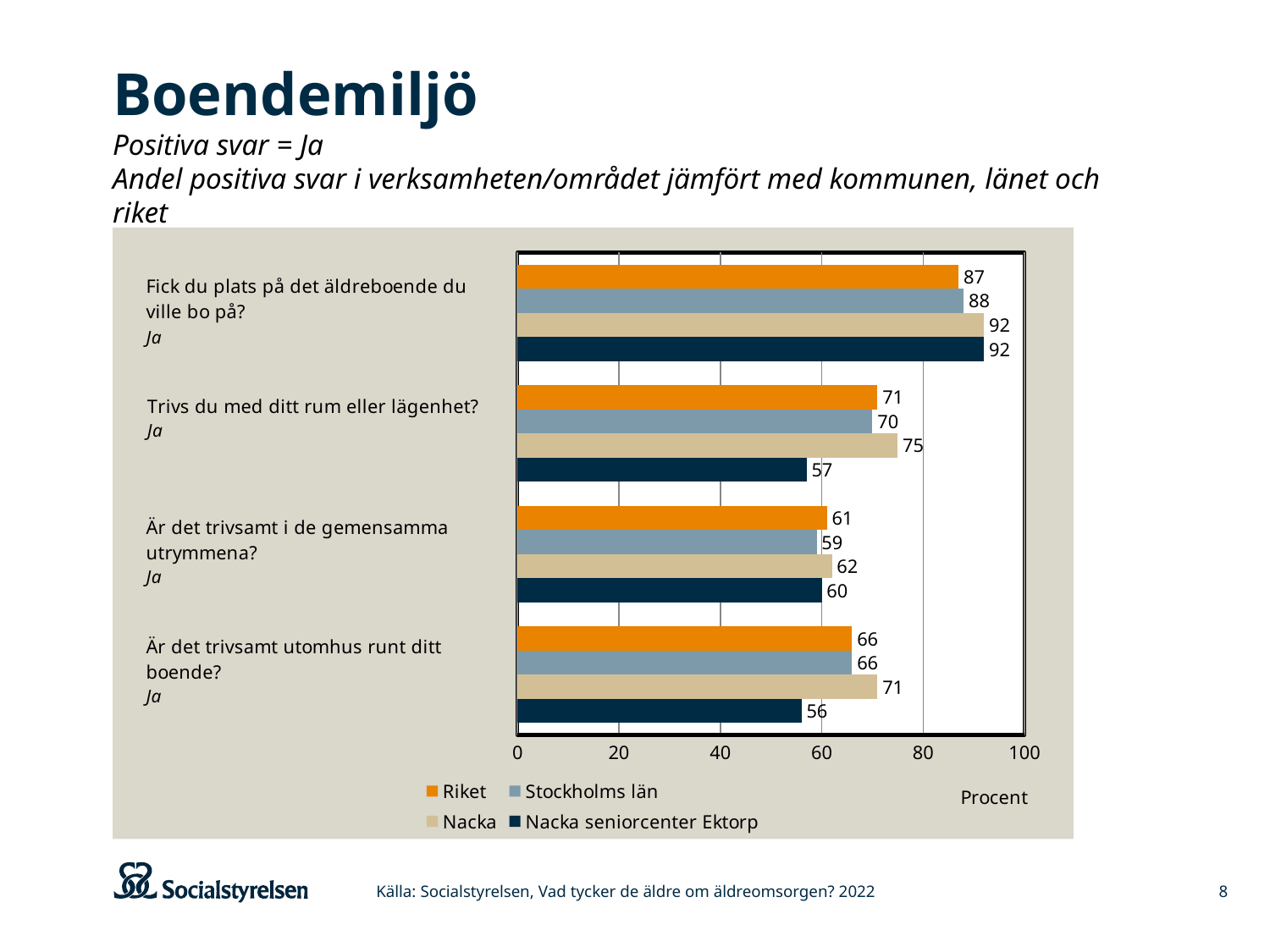
What is the value for Nacka seniorcenter Ektorp for "Fick du plats på det äldreboende du ville bo på?"? 92 What is the difference between Nacka and Nacka seniorcenter Ektorp for "Trivs du med ditt rum eller lägenhet?"? 18 Which series has the lowest value for "Trivs du med ditt rum eller lägenhet?"? Nacka seniorcenter Ektorp How many question categories are plotted on the chart? 4 What kind of chart is shown on the slide? bar chart How many series does the legend list? 4 For "Är det trivsamt utomhus runt ditt boende?", which is larger: the value for Riket or the value for Nacka seniorcenter Ektorp? Riket What is the value for Riket for "Trivs du med ditt rum eller lägenhet?"? 71 What label is shown on the x axis of the chart? Procent What is the value for Stockholms län for "Är det trivsamt i de gemensamma utrymmena?"? 59 What is the value for Nacka for "Är det trivsamt utomhus runt ditt boende?"? 71 Which series has the highest value for "Är det trivsamt utomhus runt ditt boende?"? Nacka